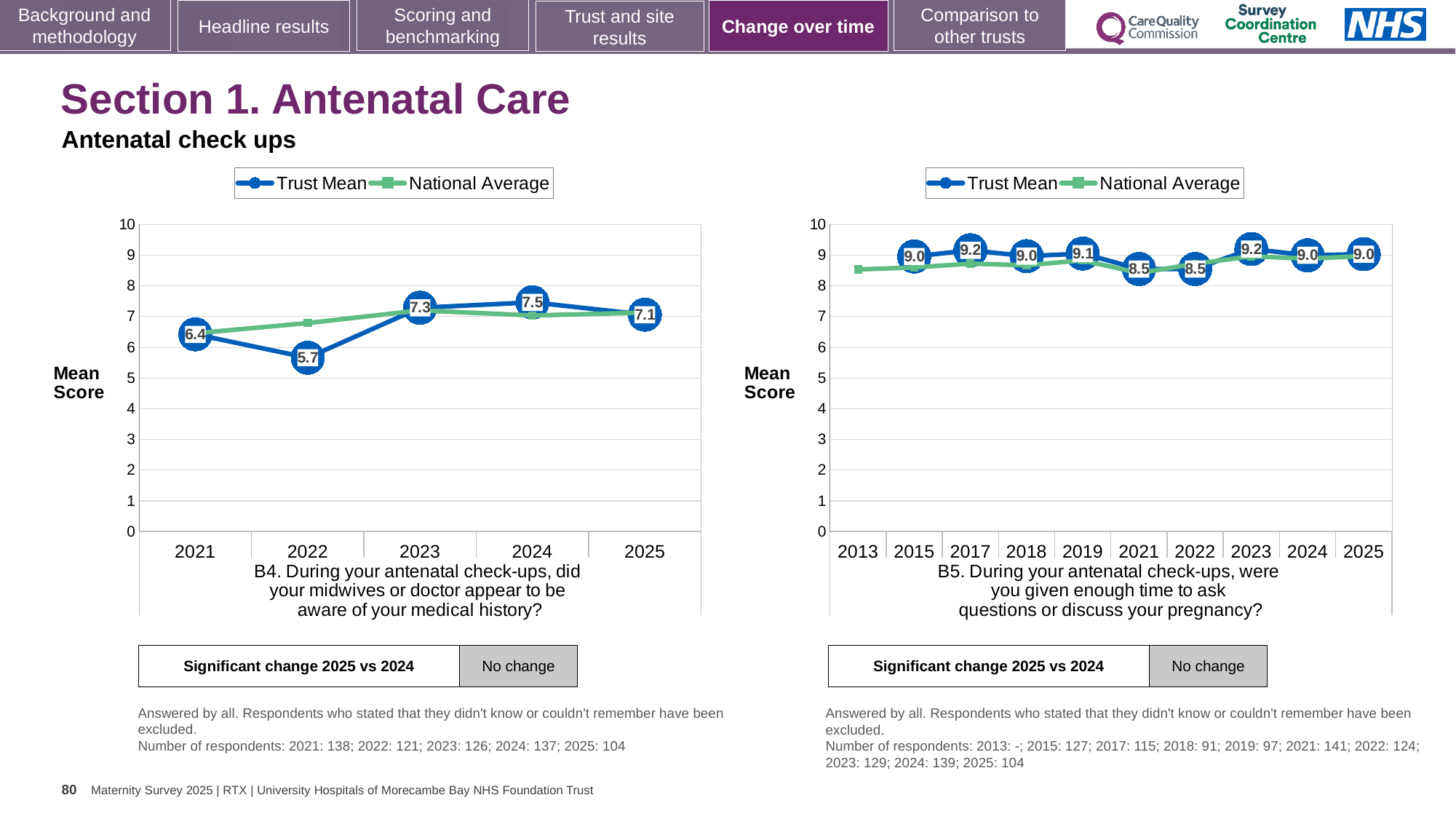
In the B4 chart (left), is the Trust Mean for 2021 greater or less than 7? less In the B4 chart (left), what is the Trust Mean for 2022? 5.7 In the B5 chart (right), is the National Average for 2013 greater or less than 8? greater In the B4 chart (left), which year has the lowest Trust Mean? 2022 In the B5 chart (right), what is the Trust Mean for 2021? 8.5 In the B4 chart (left), how many years are shown on the x axis? 5 In the B4 chart (left), what is the difference between the Trust Mean in 2024 and in 2022? 1.8 In the B5 chart (right), how many series does the legend list? 2 In the B5 chart (right), what is the Trust Mean for 2023? 9.2 What kind of chart is the B5 chart on the right? Line chart In the B5 chart (right), which is larger, the Trust Mean for 2019 or for 2022? 2019 In the B4 chart (left), what is the Trust Mean for 2024? 7.5